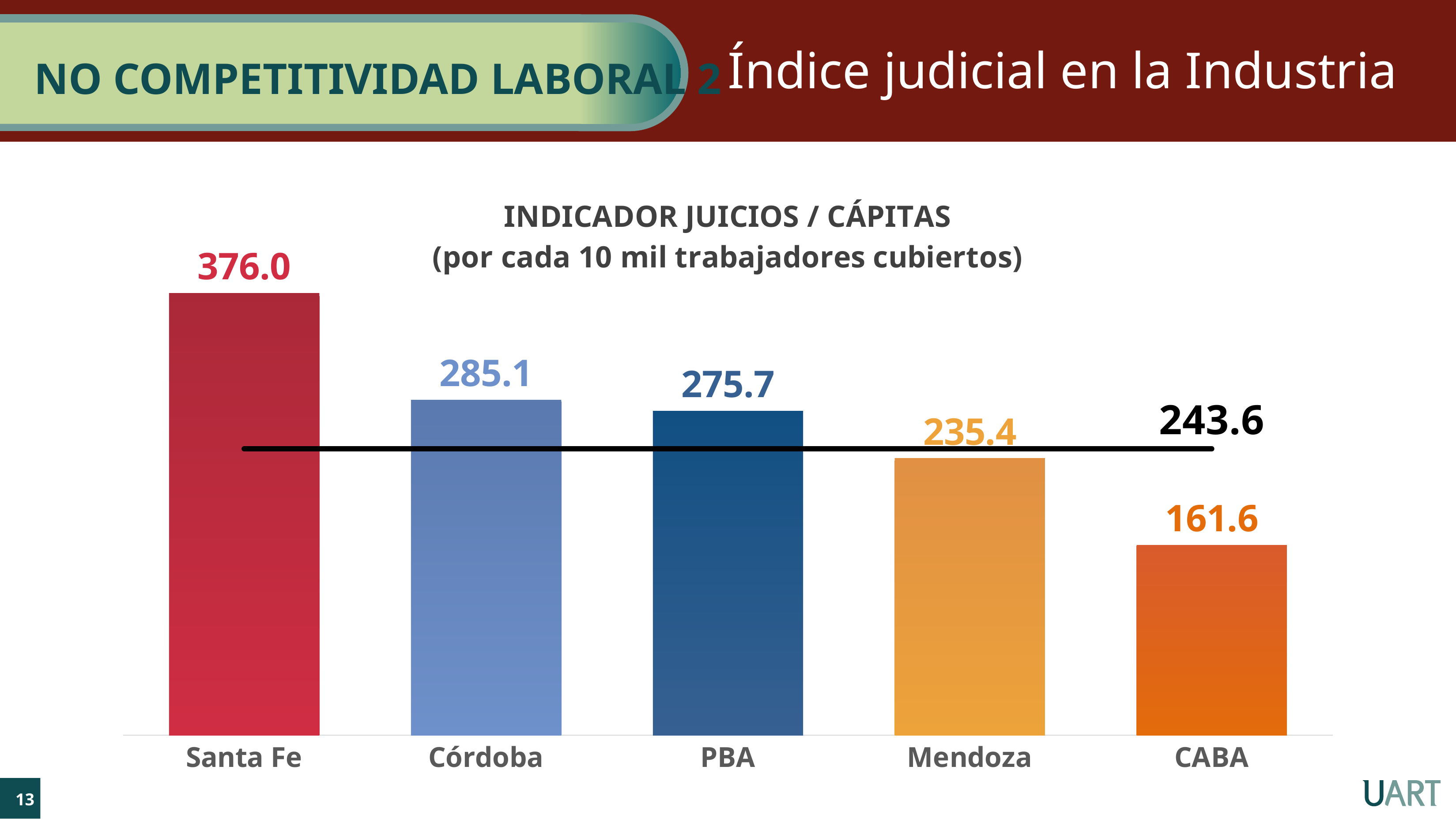
Which category has the highest value? Santa Fe Which category has the lowest value? CABA What is the difference between the values for Santa Fe and CABA? 214.4 What is the value for Córdoba? 285.1 What is the value for Mendoza? 235.4 What value is labelled on the horizontal reference line drawn across the chart? 243.6 How many categories are shown in the chart? 5 What is the value for CABA? 161.6 What is the value for PBA? 275.7 What is the value for Santa Fe? 376.0 Which is larger, the value for Córdoba or the value for Mendoza? Córdoba What kind of chart is shown on the slide? Bar chart